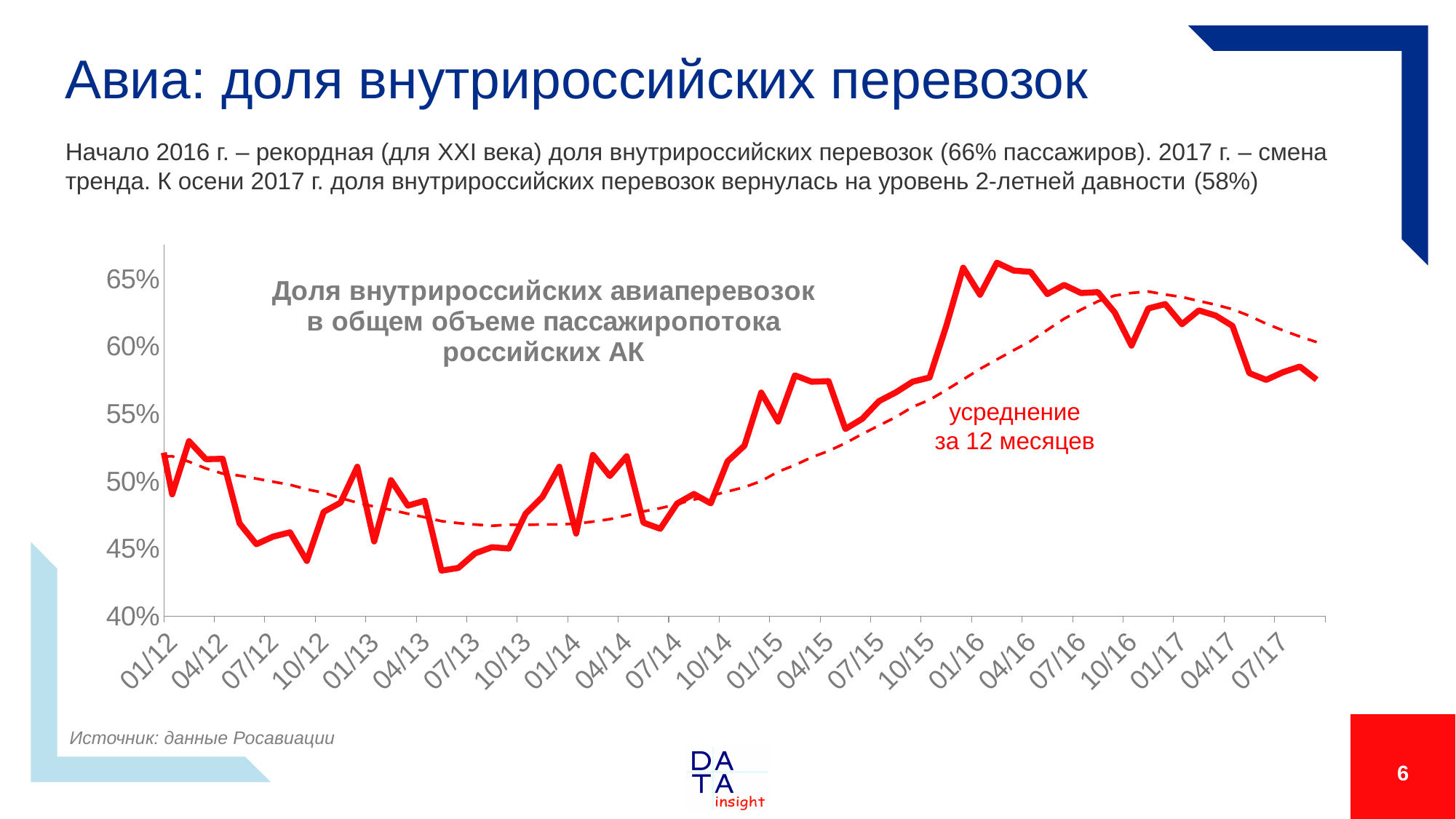
What kind of chart is shown on the slide? line chart Does the solid line generally rise or fall between 07/13 and 01/16? rise Which is larger on the solid line: the value at 07/13 or the value at 07/17? 07/17 What is the title printed inside the chart? Доля внутрироссийских авиаперевозок в общем объеме пассажиропотока российских АК How many date labels are shown on the x axis? 23 What does the dashed line on the chart represent, according to the annotation? усреднение за 12 месяцев Is the value of the solid line at 01/12 greater or less than 50%? less Is the value of the solid line at 07/17 greater or less than 55%? greater Which is larger on the solid line: the value at 01/16 or the value at 01/12? 01/16 Is the value of the solid line at 10/12 greater or less than 45%? greater